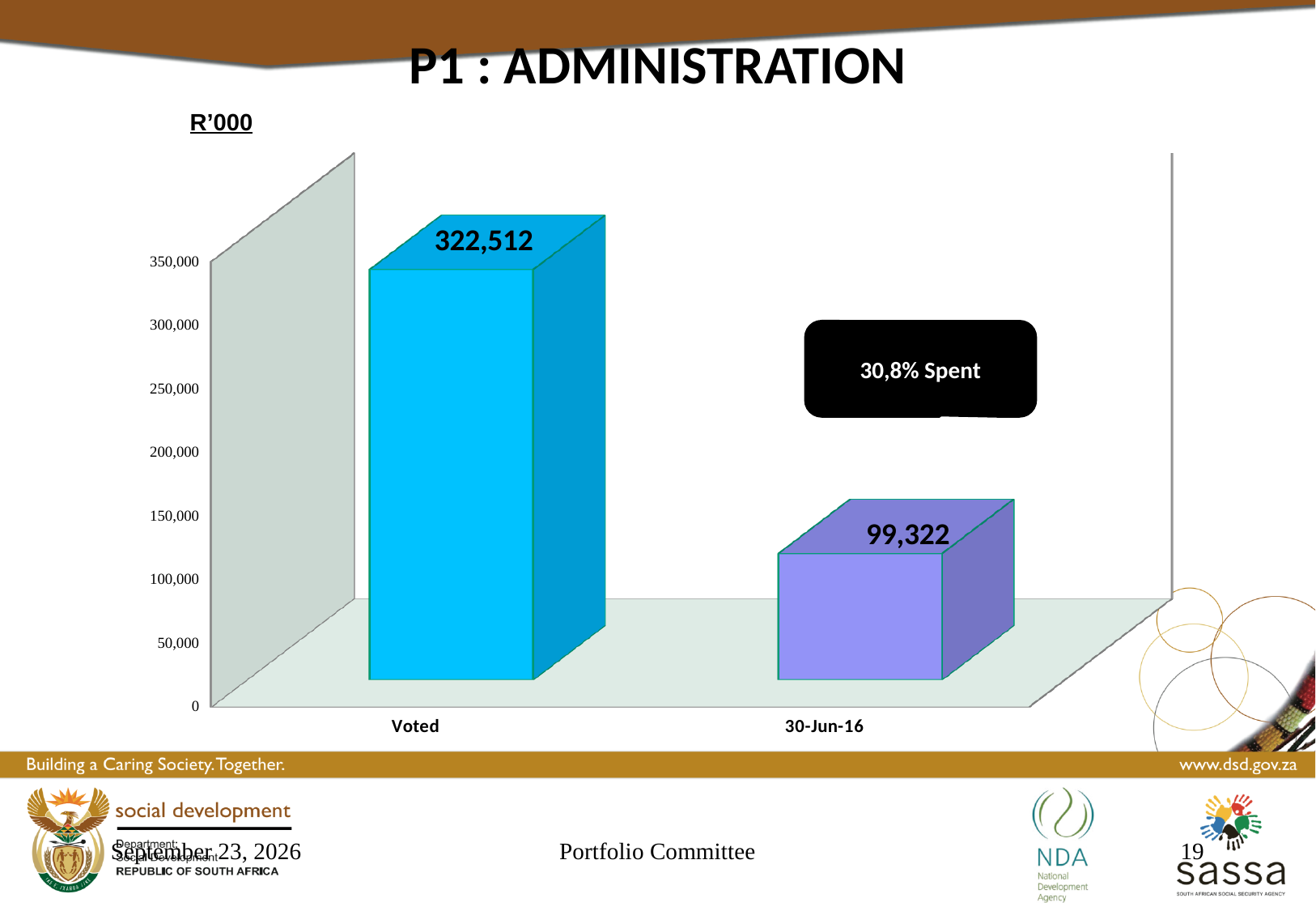
Which category has the highest value? Voted Which category has the lowest value? 30-Jun-16 What is the value of the Voted bar? 322,512 What is the difference between the Voted value and the 30-Jun-16 value? 223,190 What kind of chart is shown on the slide? bar chart Which is larger, the Voted value or the 30-Jun-16 value? Voted What is the value of the 30-Jun-16 bar? 99,322 How many bars are plotted in the chart? 2 What is the title of the slide containing the chart? P1 : ADMINISTRATION Is the value for 30-Jun-16 greater or less than 150,000? less What percentage spent is shown in the callout on the chart? 30,8% Spent Is the value for Voted greater or less than 300,000? greater